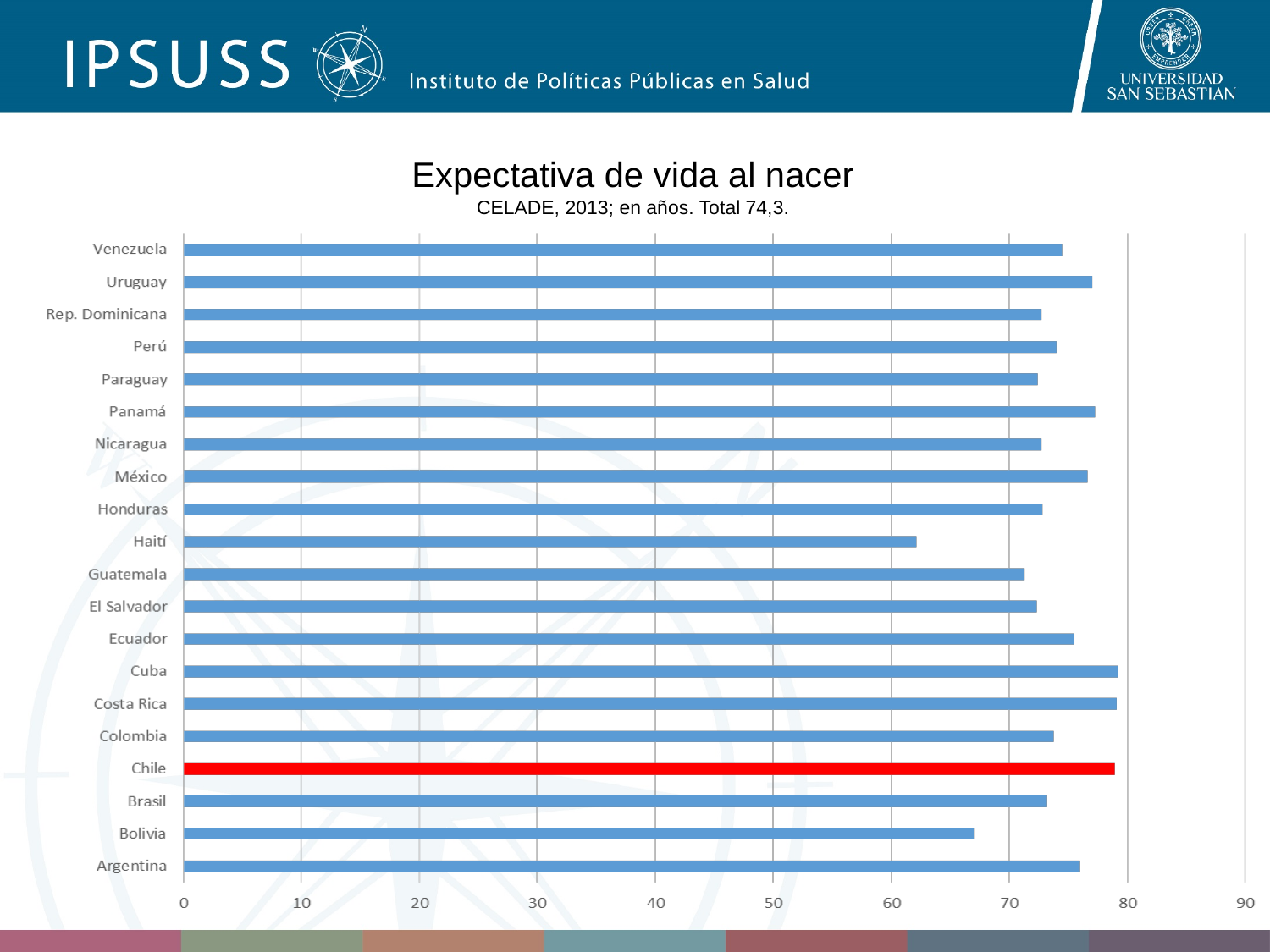
Is the value for Chile greater or less than 70? greater Is the value for Haití greater or less than 70? less Which country's bar is coloured red in the chart? Chile Which has the higher life expectancy, Haití or Argentina? Argentina Which has the higher life expectancy, Chile or Brasil? Chile What is the title of the chart? Expectativa de vida al nacer Which country has the lowest life expectancy at birth in the chart? Haití What kind of chart is shown on the slide? bar chart How many countries are listed in the chart? 20 Is the value for Bolivia greater or less than 70? less Which has the higher life expectancy, Uruguay or Bolivia? Uruguay